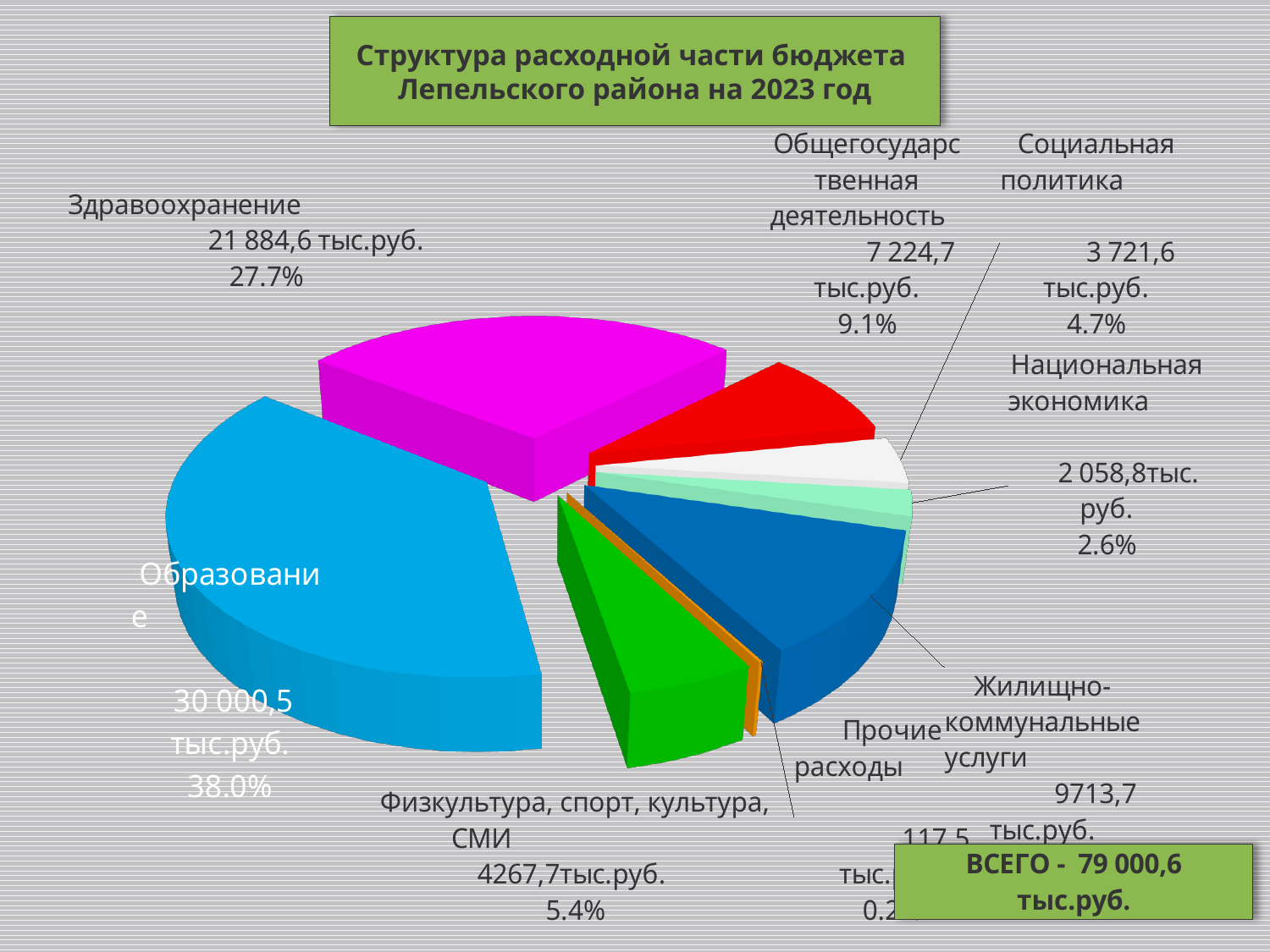
What is the value shown for Национальная экономика? 2 058,8тыс.руб. What percentage share is shown for Физкультура, спорт, культура, СМИ? 5.4% What percentage share is shown for Социальная политика? 4.7% By how many percentage points does the share of Образование exceed the share of Здравоохранение? 10.3 Which category has the largest share of the budget expenditure? Образование Which category has the smallest slice of the pie? Прочие расходы What kind of chart is shown on the slide? pie chart What is the value shown for Общегосударственная деятельность? 7 224,7 тыс.руб. What percentage of the budget goes to Образование? 38.0% Which is larger: Общегосударственная деятельность or Социальная политика? Общегосударственная деятельность What is the value shown for Здравоохранение? 21 884,6 тыс.руб. How many categories are shown in the pie chart? 8